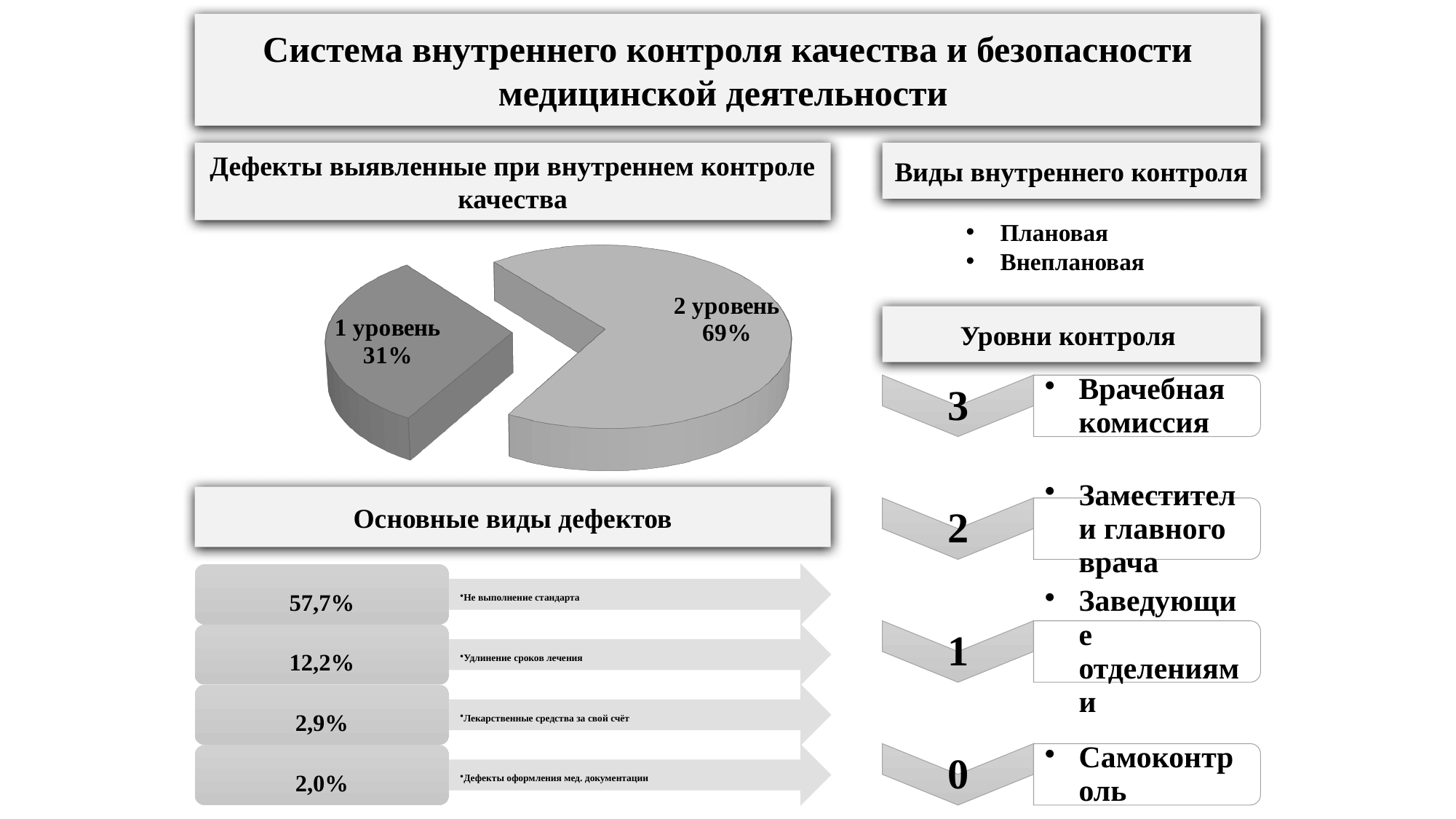
Which slice of the pie chart is the largest? 2 уровень Which slice of the pie chart is shaded darker? 1 уровень What kind of chart is shown under the heading "Дефекты выявленные при внутреннем контроле качества"? pie chart In the pie chart, which is larger: the share for "1 уровень" or for "2 уровень"? 2 уровень Is the share for "1 уровень" in the pie chart greater or less than 50%? less In the pie chart, what share is labelled for "1 уровень"? 31% Which slice of the pie chart is the smallest? 1 уровень In the pie chart, what share is labelled for "2 уровень"? 69% How many slices does the pie chart have? 2 Which slice of the pie chart is pulled out (exploded) from the rest? 1 уровень What is the difference in percentage points between the "2 уровень" and "1 уровень" slices of the pie chart? 38